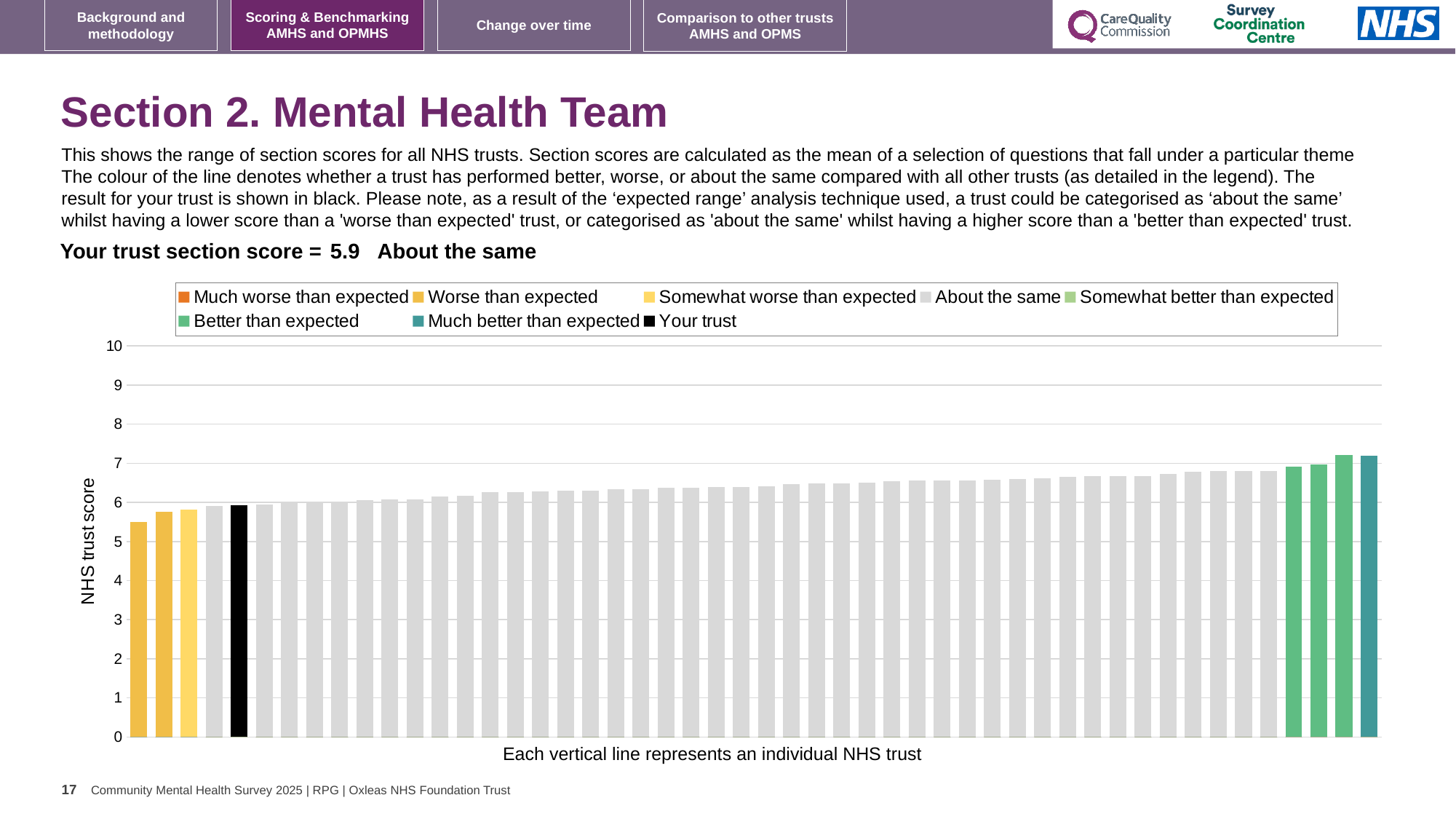
Is the value for your trust greater or less than 5? greater Which category is your trust placed in for this section? About the same What is the section score for your trust shown on the slide? 5.9 What colour is the bar representing your trust? black What is the highest value shown on the y axis? 10 How many entries does the chart legend list? 8 What is the label on the y axis of the chart? NHS trust score Do the bar values rise or fall from left to right along the x axis? rise What kind of chart is shown on the slide? bar chart Is the value for the tallest bar greater or less than 7? greater Is the value for the shortest bar greater or less than 6? less